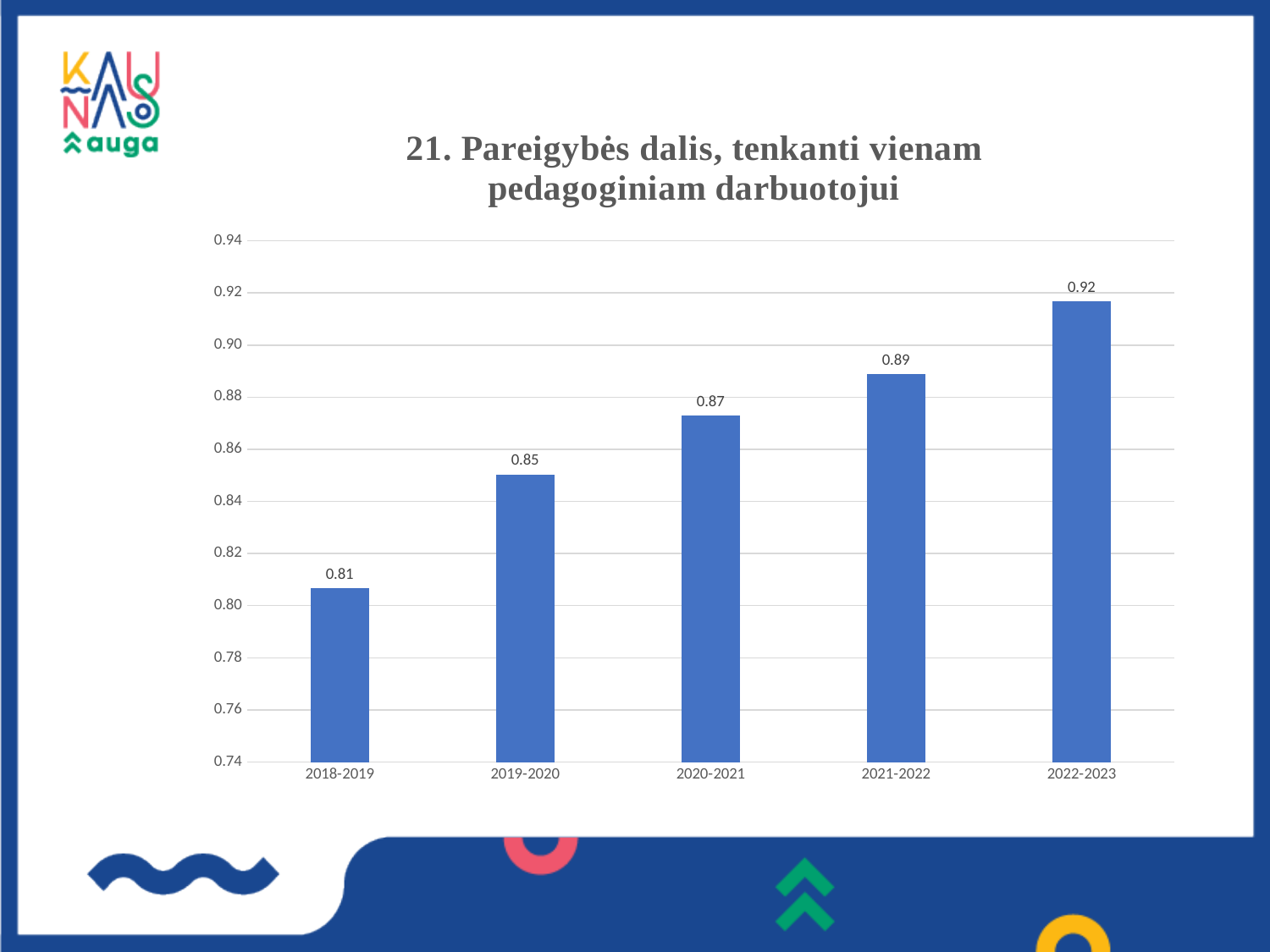
What is the value for 2018-2019? 0.81 Which is larger, the value for 2019-2020 or the value for 2021-2022? 2021-2022 What kind of chart is shown on the slide? bar chart Which school year has the lowest value? 2018-2019 What is the value for 2020-2021? 0.87 What is the difference between the values for 2021-2022 and 2019-2020? 0.04 Which school year has the highest value? 2022-2023 How many school years are shown on the chart? 5 What is the difference between the values for 2022-2023 and 2018-2019? 0.11 Is the value for 2020-2021 greater or less than 0.90? less What is the value for 2022-2023? 0.92 Do the values rise or fall from 2018-2019 to 2022-2023? rise